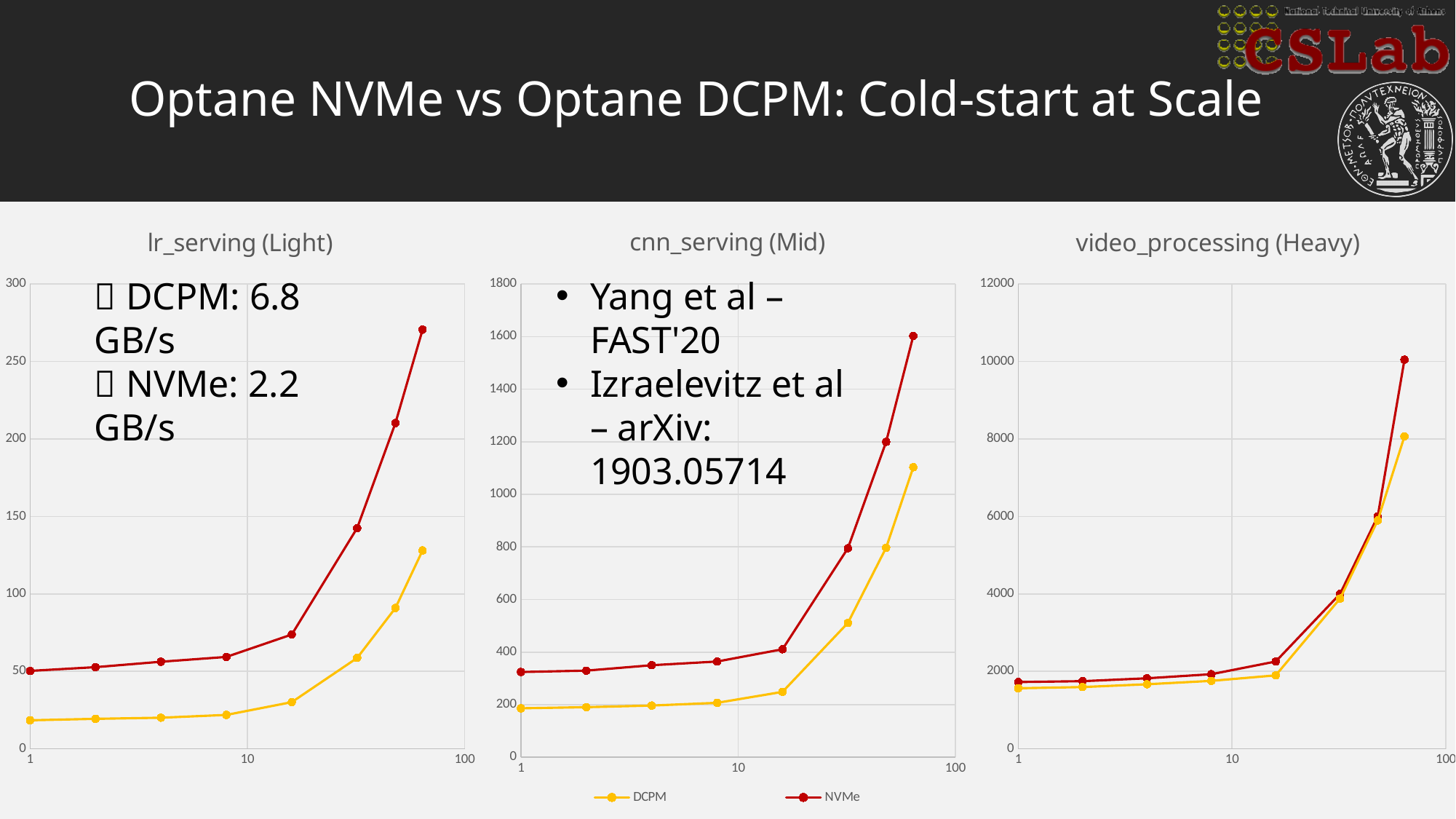
In the cnn_serving (Mid) chart, how many data points are plotted for the NVMe series? 8 In the video_processing (Heavy) chart, do the DCPM values rise or fall as the x axis increases? rise In the lr_serving (Light) chart, which series has the higher value at the rightmost point, DCPM or NVMe? NVMe Which colour represents the DCPM series in the charts? yellow In the lr_serving (Light) chart, is the rightmost NVMe value greater or less than 250? greater How many series does the legend list for the charts? 2 In the lr_serving (Light) chart, is the leftmost DCPM value greater or less than 50? less In the video_processing (Heavy) chart, is the leftmost NVMe value greater or less than 2000? less What is the title of the rightmost chart on the slide? video_processing (Heavy) What kind of chart is the lr_serving (Light) chart? line chart